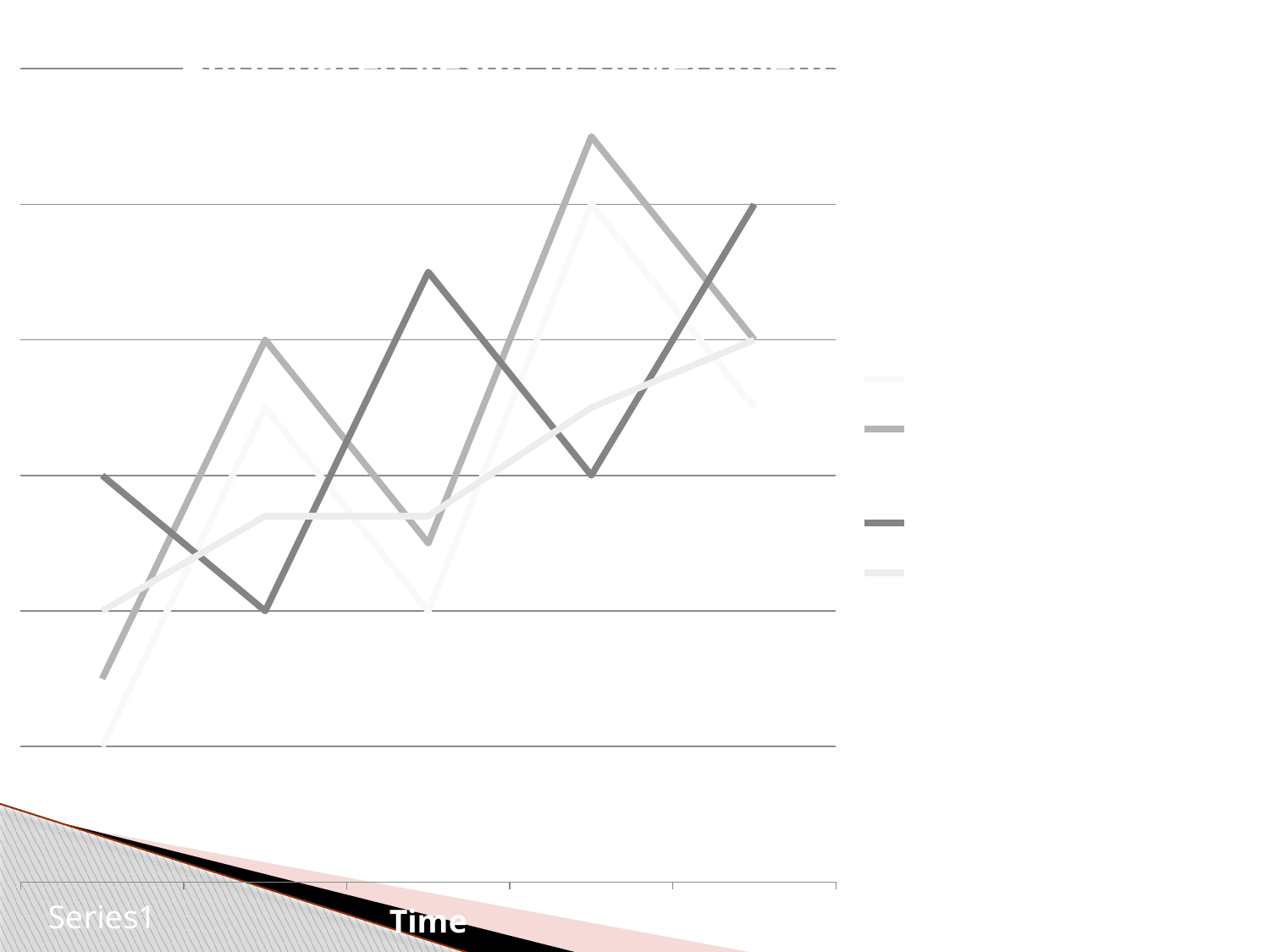
What kind of chart is shown on the slide? line chart How many points along the x axis does each line have? 5 How many series does the legend list? 4 Does the lightest grey line that starts near the bottom-left rise or fall overall along the x axis? rise What is the title of the horizontal axis? Time